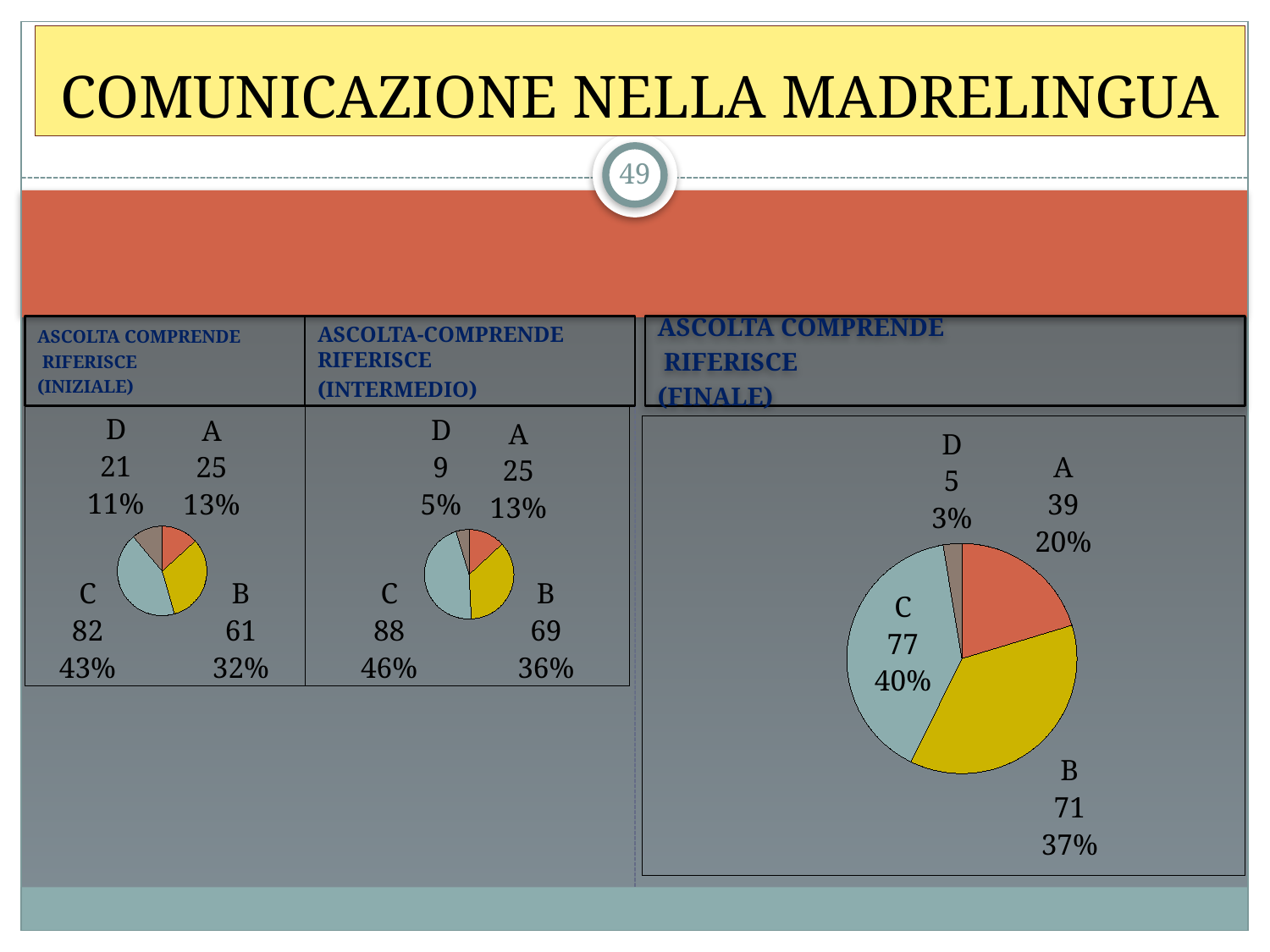
In the FINALE chart, what is the value for category A? 39 In the INTERMEDIO chart, what is the difference between the values for C and B? 19 In the INTERMEDIO chart, what is the value for category D? 9 In the INIZIALE chart, which category has the lowest value? D In the FINALE chart, what percentage share does category C have? 40% How many categories does the FINALE chart show? 4 In the INTERMEDIO chart, which category has the highest value? C What kind of chart is used in the INIZIALE panel? Pie chart In the FINALE chart, which is larger, the value for B or the value for A? B In the INIZIALE chart, what is the value for category C? 82 In the INIZIALE chart, what percentage share does category B have? 32% In the FINALE chart, what is the difference between the values for C and D? 72